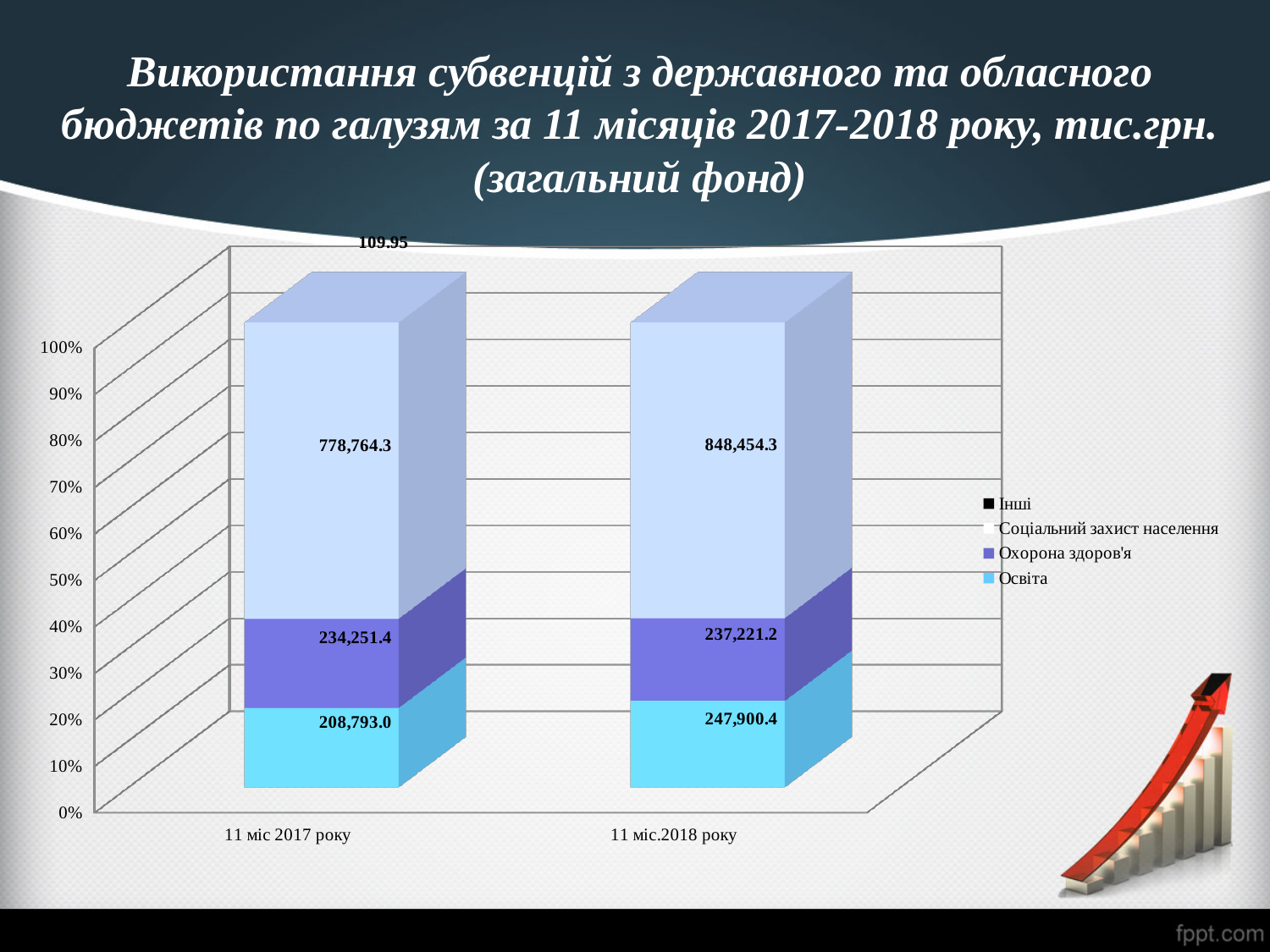
How many categories are shown on the x axis? 2 Which series has the largest segment in the 11 міс.2018 року bar? Соціальний захист населення How many series does the legend list? 4 What is the value of Охорона здоров'я for 11 міс.2018 року? 237,221.2 By how much did the value of Освіта increase from 11 міс 2017 року to 11 міс.2018 року? 39,107.4 What is the value of Охорона здоров'я for 11 міс 2017 року? 234,251.4 What is the value of Освіта for 11 міс 2017 року? 208,793.0 What is the value of Освіта for 11 міс.2018 року? 247,900.4 What kind of chart is shown on the slide? Stacked bar chart What is the value of Соціальний захист населення for 11 міс.2018 року? 848,454.3 Which is larger: Охорона здоров'я for 11 міс 2017 року or Освіта for 11 міс 2017 року? Охорона здоров'я for 11 міс 2017 року What is the difference between the Соціальний захист населення values for 11 міс.2018 року and 11 міс 2017 року? 69,690.0